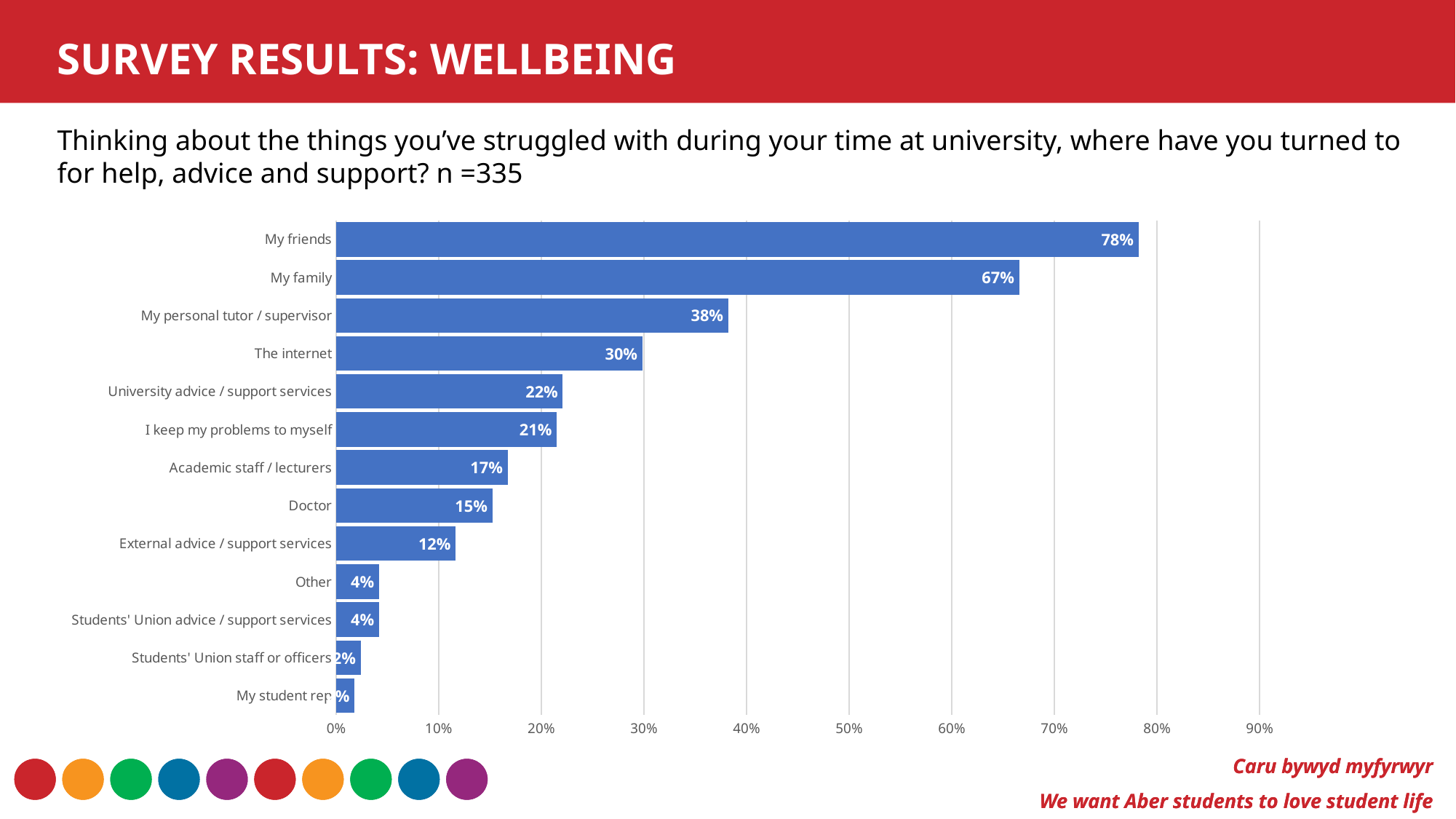
Which is larger: the value for 'University advice / support services' or the value for 'Academic staff / lecturers'? University advice / support services What percentage of respondents turned to their friends for help, advice and support? 78% How many categories (sources of help) are shown in the chart? 13 What is the value shown for 'My personal tutor / supervisor'? 38% Which source of help has the highest percentage in the chart? My friends What is the sample size (n) stated in the survey question above the chart? 335 What is the value for 'External advice / support services'? 12% What is the difference in percentage points between 'The internet' and 'Doctor'? 15 What percentage of respondents said they keep their problems to themselves? 21% What is the difference in percentage points between 'My friends' and 'My family'? 11 What type of chart is used on this slide? Bar chart Is the value for 'My student rep' greater or less than 10%? less